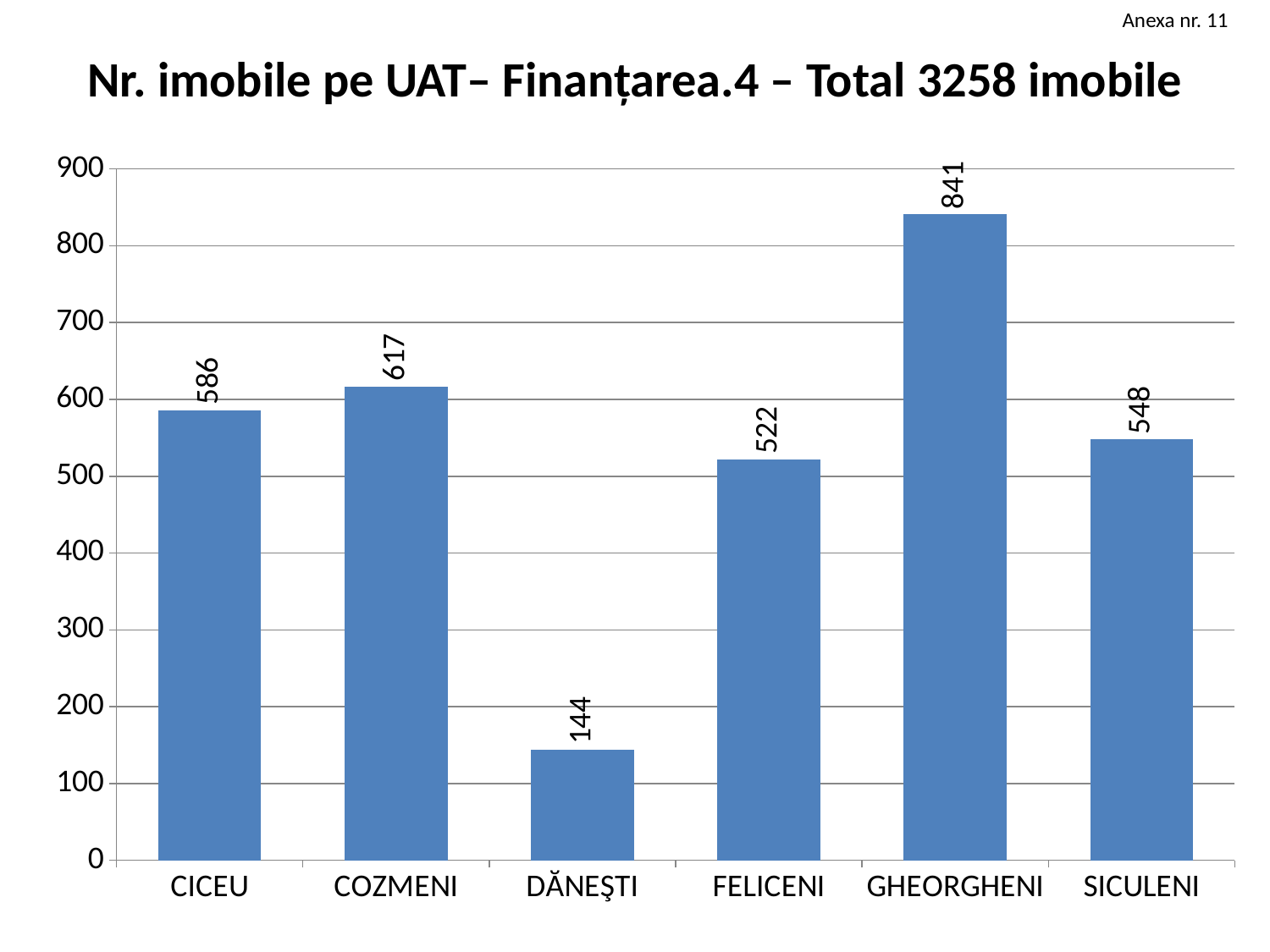
Which is larger, the value for SICULENI or the value for FELICENI? SICULENI What is the value for SICULENI? 548 What is the title of the chart? Nr. imobile pe UAT– Finanțarea.4 – Total 3258 imobile What kind of chart is shown on the slide? bar chart Which UAT has the highest number of imobile? GHEORGHENI What is the difference between the values for GHEORGHENI and FELICENI? 319 What is the difference between the values for COZMENI and CICEU? 31 Is the value for CICEU greater or less than 500? greater What is the value for GHEORGHENI? 841 What is the value for DĂNEŞTI? 144 Which UAT has the lowest number of imobile? DĂNEŞTI How many UATs are shown on the chart? 6